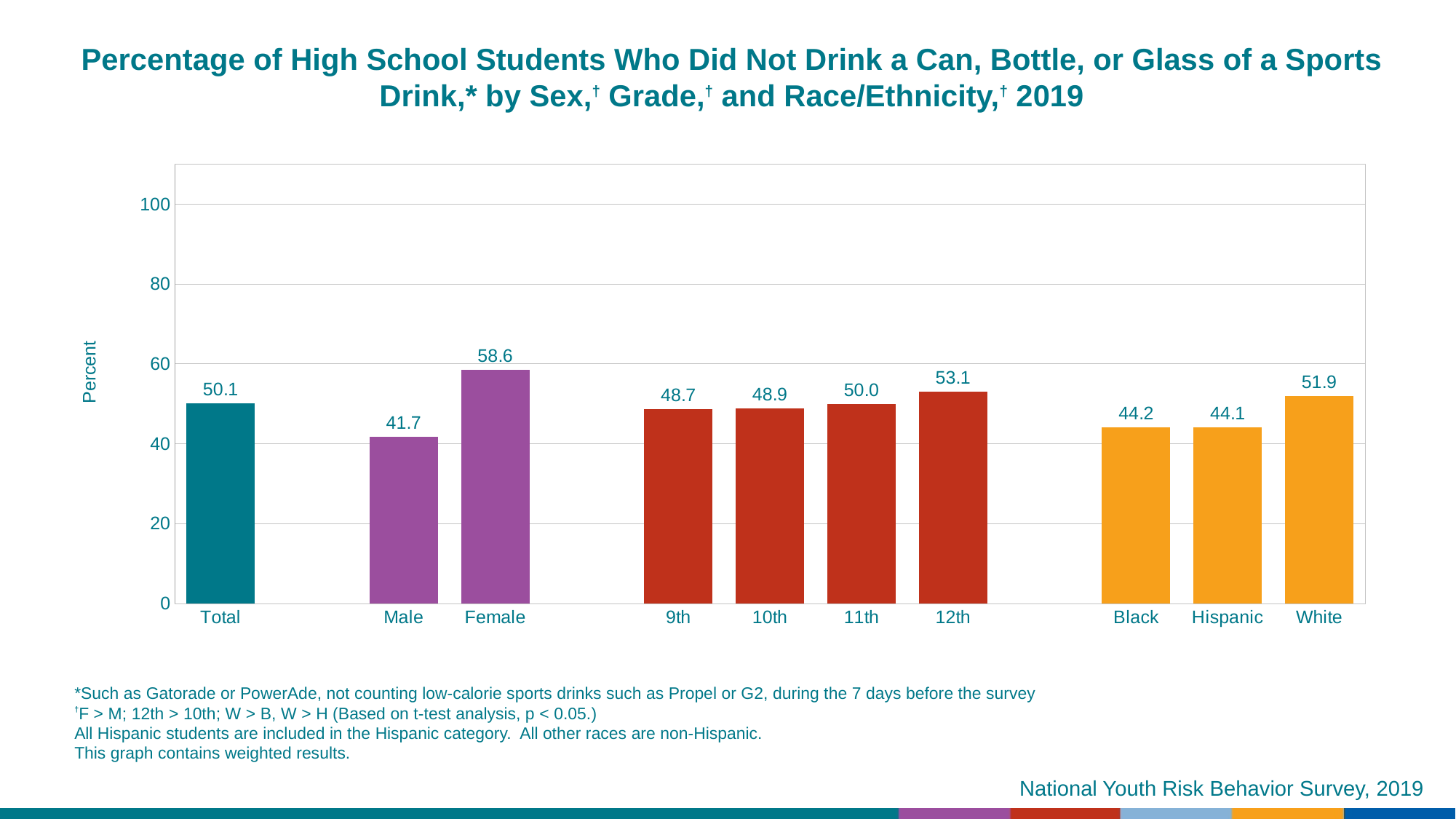
Is the value for Male greater or less than 40? greater What is the label of the y axis? Percent What is the value for 12th grade? 53.1 What is the value for Hispanic students? 44.1 What is the difference between the Female and Male values? 16.9 Which category has the highest value? Female What is the value for Female? 58.6 Which category has the lowest value? Male What is the difference between the White and Black values? 7.7 What kind of chart is shown on the slide? bar chart How many bars are shown in the chart? 10 Which is larger, the value for 12th grade or the value for 9th grade? 12th